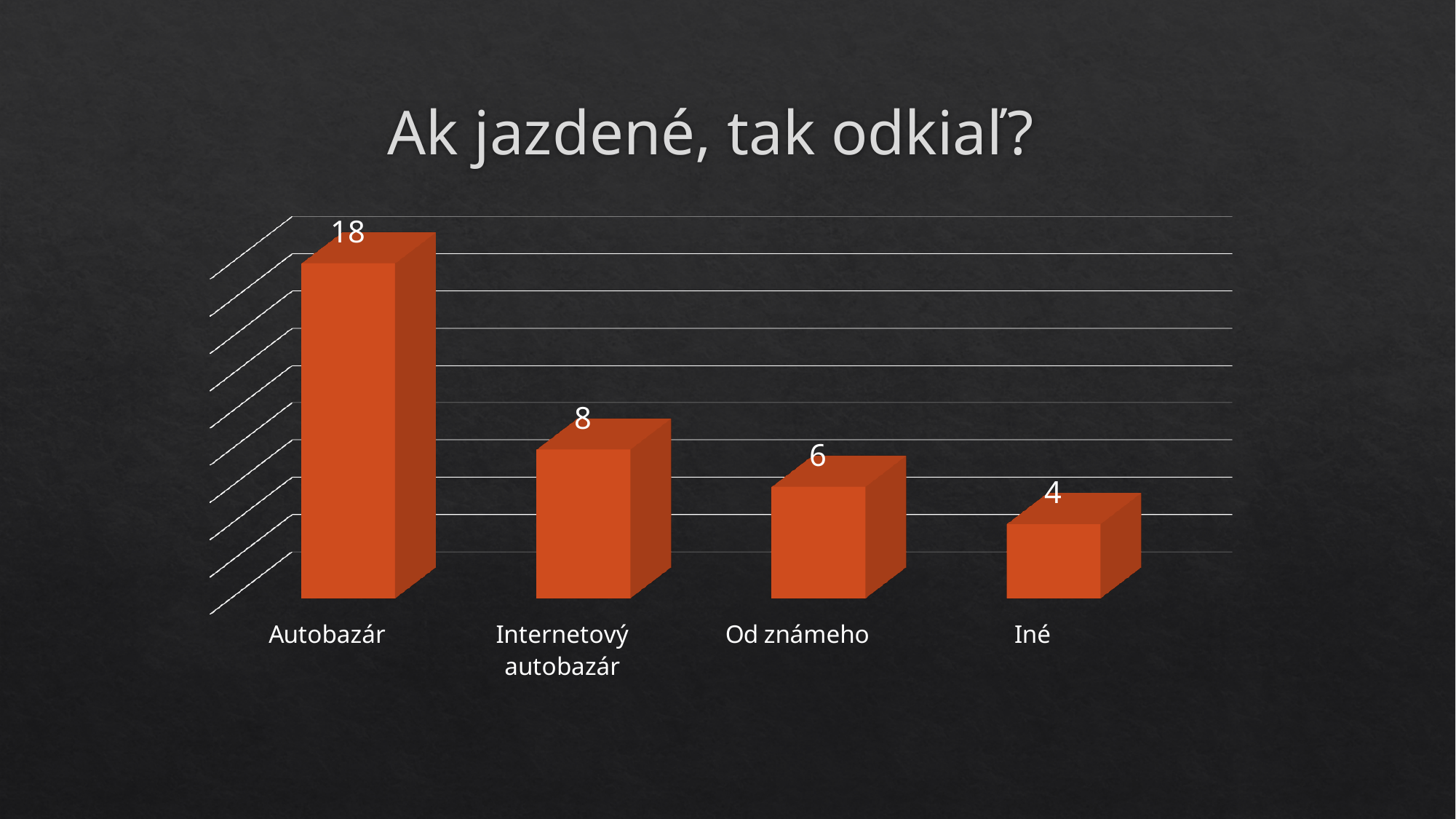
What is the title of the slide? Ak jazdené, tak odkiaľ? What is the value for Od známeho? 6 How many categories are shown in the chart? 4 Which is larger, the value for Internetový autobazár or the value for Od známeho? Internetový autobazár What kind of chart is shown on the slide? Bar chart What is the difference between the values for Autobazár and Internetový autobazár? 10 What is the value for Iné? 4 What is the difference between the values for Od známeho and Iné? 2 What is the value for Internetový autobazár? 8 Which category has the highest value? Autobazár What is the value for Autobazár? 18 Which category has the lowest value? Iné